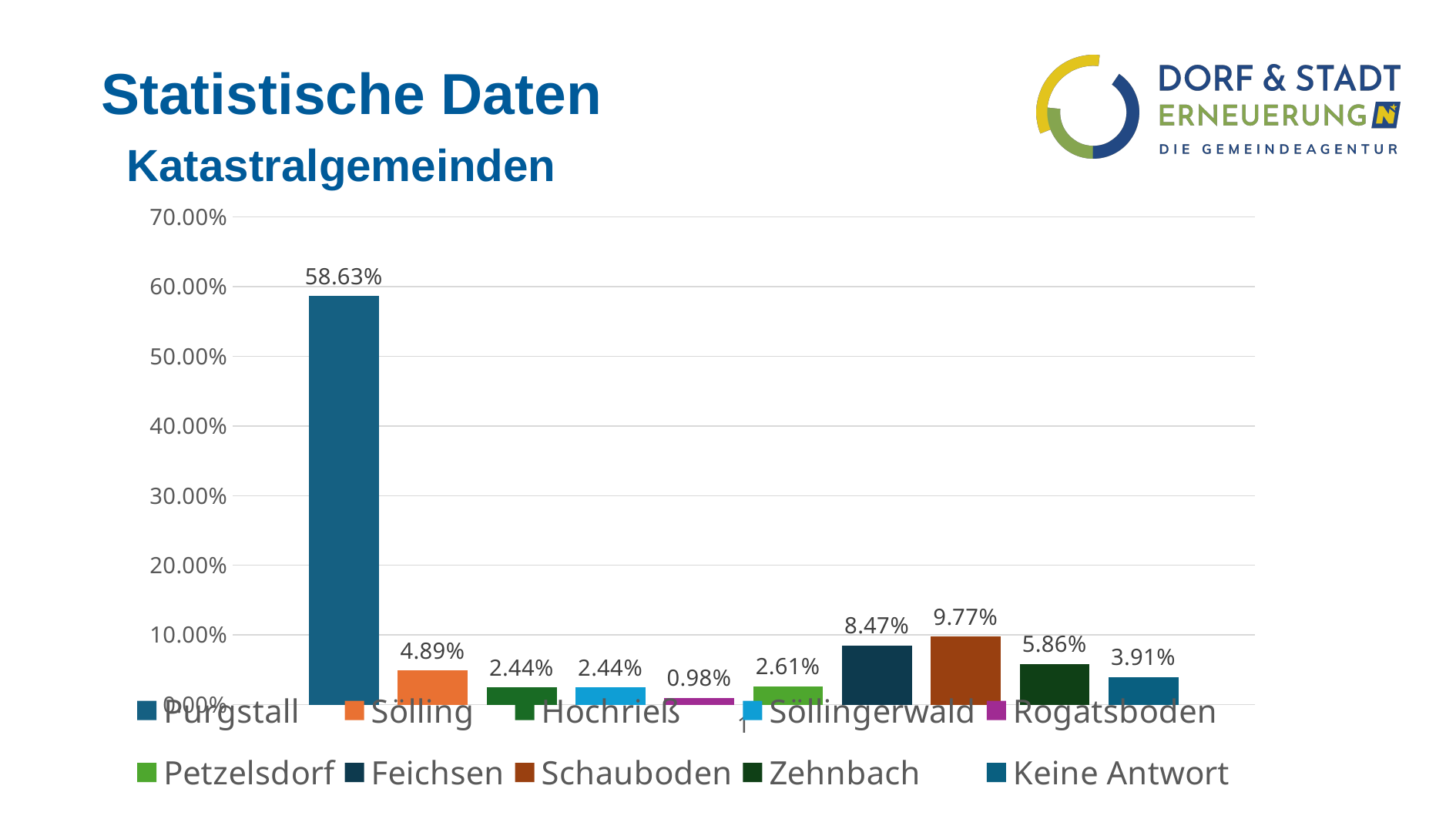
Which category has the lowest value? Rogatsboden Is the value for Feichsen greater or less than 10.00%? less Which is larger, the value for Sölling or the value for Zehnbach? Zehnbach What kind of chart is shown on the slide? bar chart Which category has the highest value? Purgstall What is the value for Keine Antwort? 3.91% What is the value for Rogatsboden? 0.98% What is the difference between the values for Schauboden and Feichsen? 1.30% What is the title of the chart? Katastralgemeinden What is the value for Purgstall? 58.63% What is the value for Schauboden? 9.77% How many categories are shown in the chart? 10